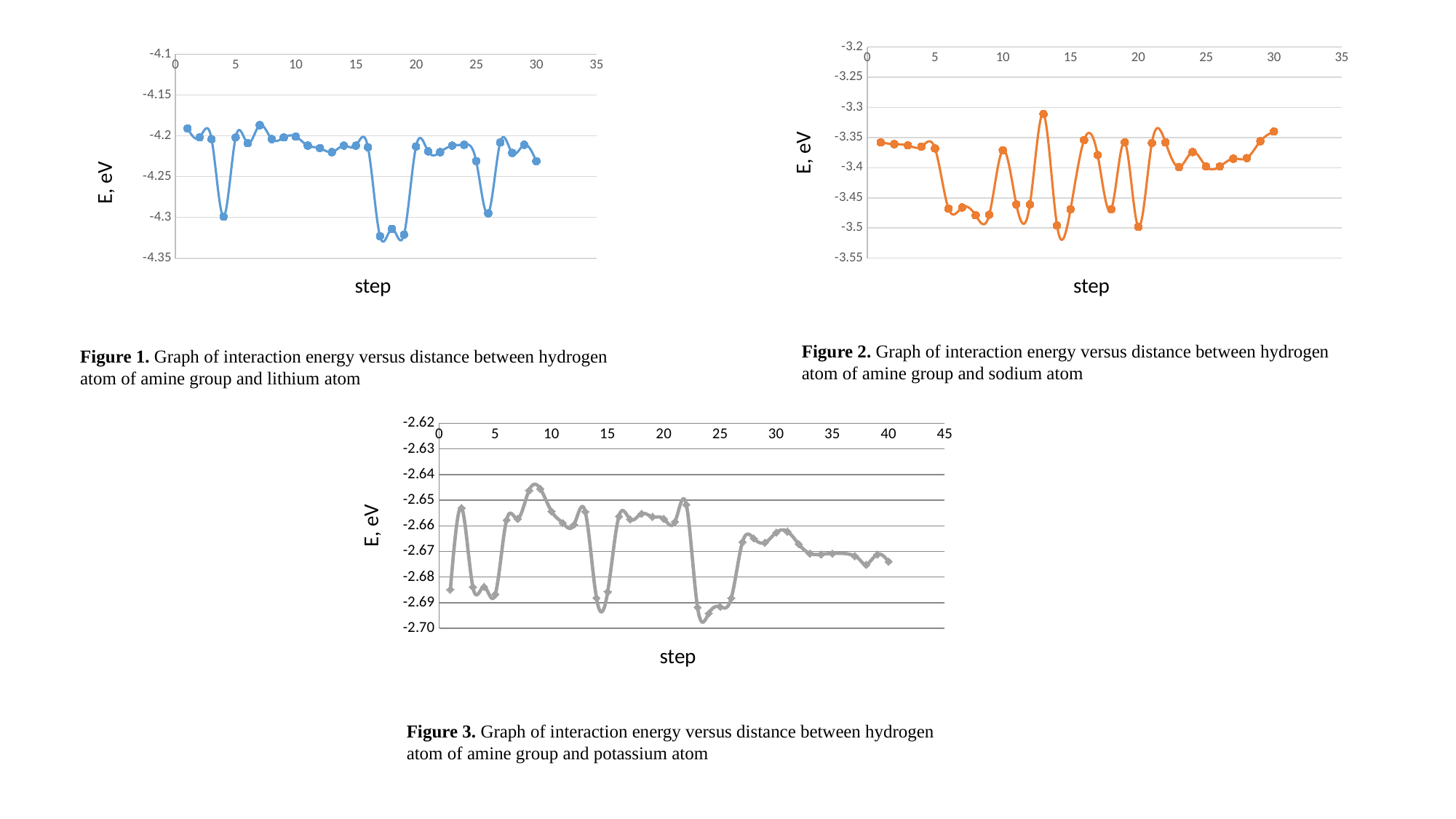
In Figure 1, is the value at step 1 greater or less than -4.2? greater What kind of chart is Figure 1? line chart What is the y-axis title of the Figure 3 chart? E, eV In Figure 2, is the value at step 13 greater or less than -3.35? greater In Figure 3, do the values rise or fall between step 30 and step 40? fall In Figure 1, is the value at step 17 greater or less than -4.3? less In Figure 2, do the values rise or fall between step 25 and step 30? rise What is the x-axis title of the Figure 2 chart? step How many charts are shown on the slide? 3